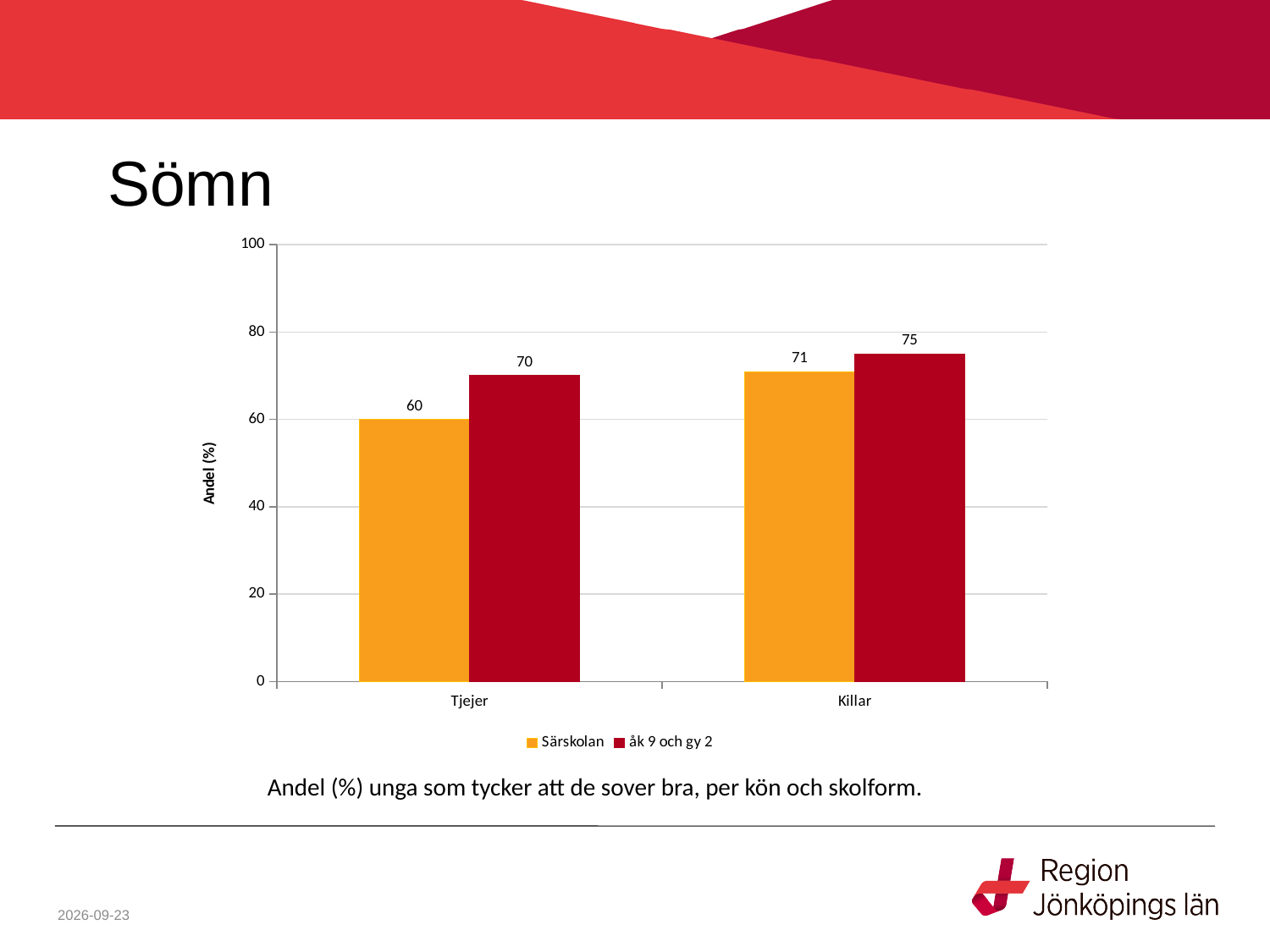
What kind of chart is shown on the slide? bar chart What is the value for åk 9 och gy 2 in the Tjejer category? 70 What is the value for åk 9 och gy 2 in the Killar category? 75 What is the difference between the åk 9 och gy 2 value and the Särskolan value for Tjejer? 10 What is the value for Särskolan in the Killar category? 71 Is the value for Särskolan in the Tjejer category greater or less than 80? less Which is larger for Killar: the Särskolan value or the åk 9 och gy 2 value? åk 9 och gy 2 Which category has the highest value for the Särskolan series? Killar What is the value for Särskolan in the Tjejer category? 60 How many categories are shown on the x axis? 2 Which category has the lowest value for the åk 9 och gy 2 series? Tjejer How many series does the legend list? 2